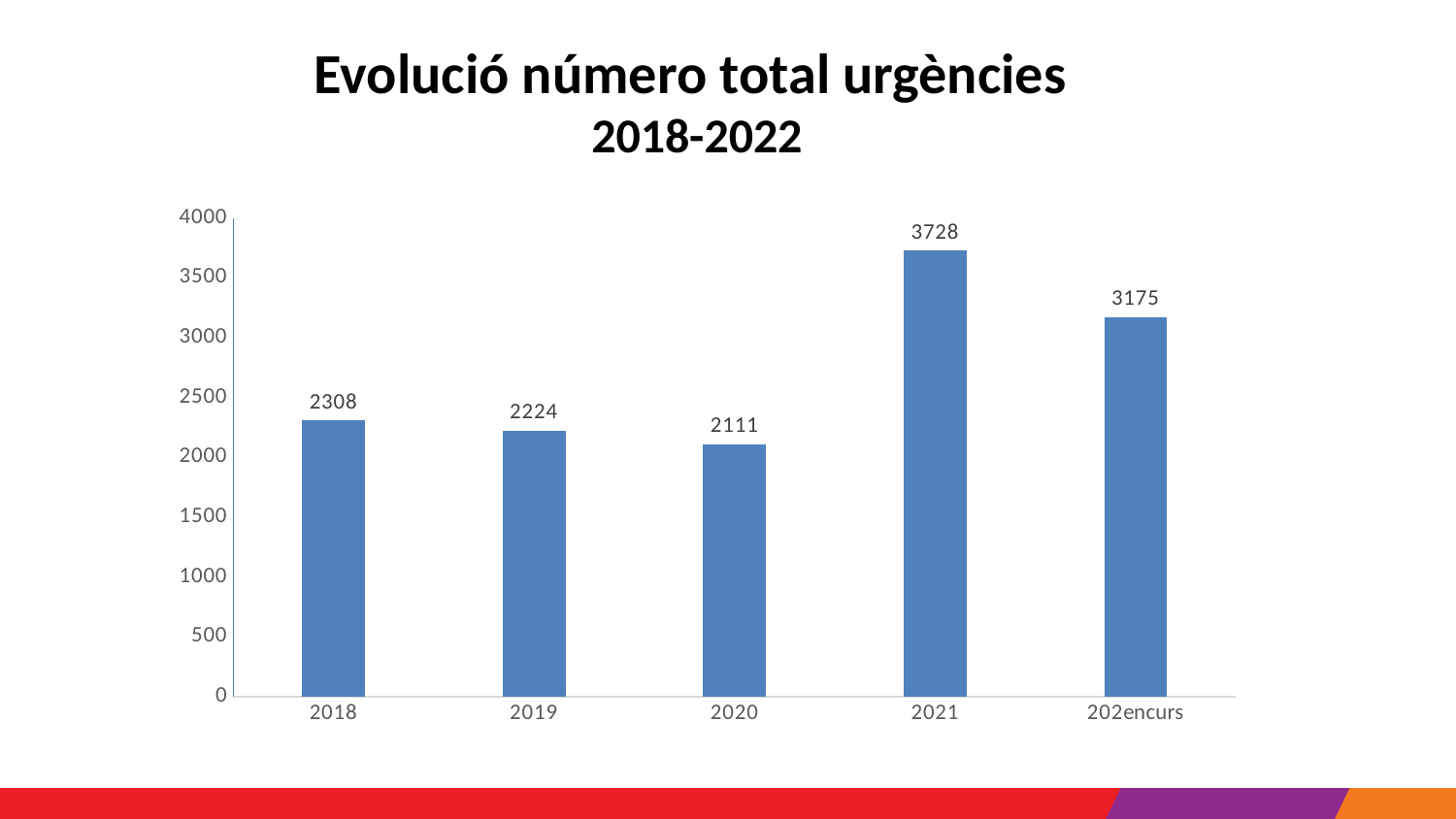
What is the value for 2020? 2111 What kind of chart is shown on the slide? Bar chart What is the value for 2021? 3728 How many bars are shown in the chart? 5 What is the value for the category labelled 202encurs? 3175 Which is larger, the value for 2019 or the value for 202encurs? 202encurs What is the value for 2018? 2308 Which category has the highest value? 2021 Which category has the lowest value? 2020 What is the difference between the values for 2021 and 2020? 1617 What is the title of the chart? Evolució número total urgències 2018-2022 What is the difference between the values for 2018 and 2019? 84